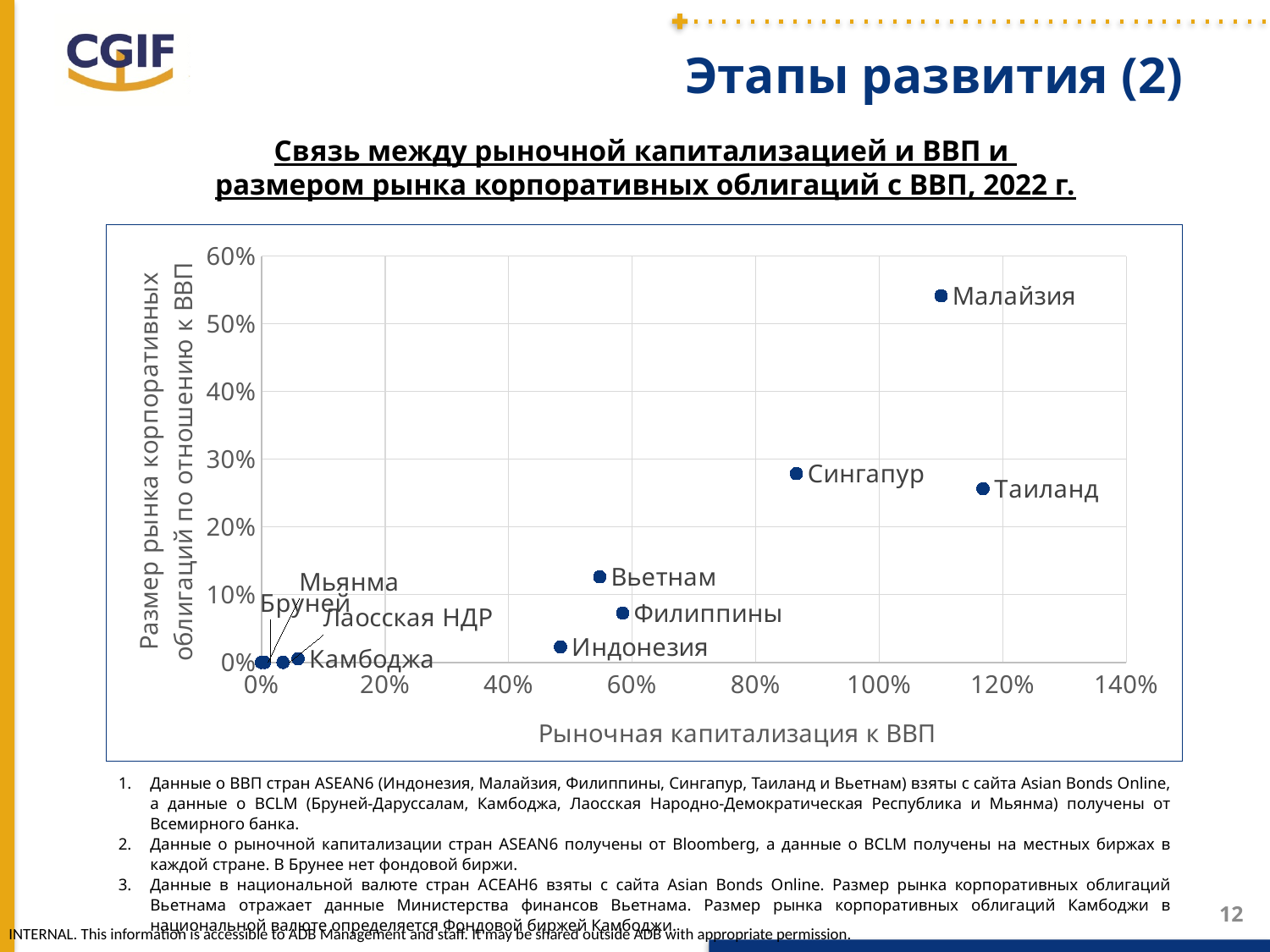
What is the label of the horizontal axis of the chart? Рыночная капитализация к ВВП Is the vertical-axis value for Сингапур greater or less than 30%? less What kind of chart is shown on the slide? Scatter chart Which has a higher market capitalisation to GDP, Сингапур or Таиланд? Таиланд Is the horizontal-axis value for Вьетнам greater or less than 60%? less Which country has the highest market capitalisation to GDP (horizontal axis)? Таиланд How many countries are plotted on the chart? 10 Is the vertical-axis value for Индонезия greater or less than 10%? less Which country has the highest corporate bond market size relative to GDP (vertical axis)? Малайзия Which has a higher corporate bond market size relative to GDP, Вьетнам or Филиппины? Вьетнам